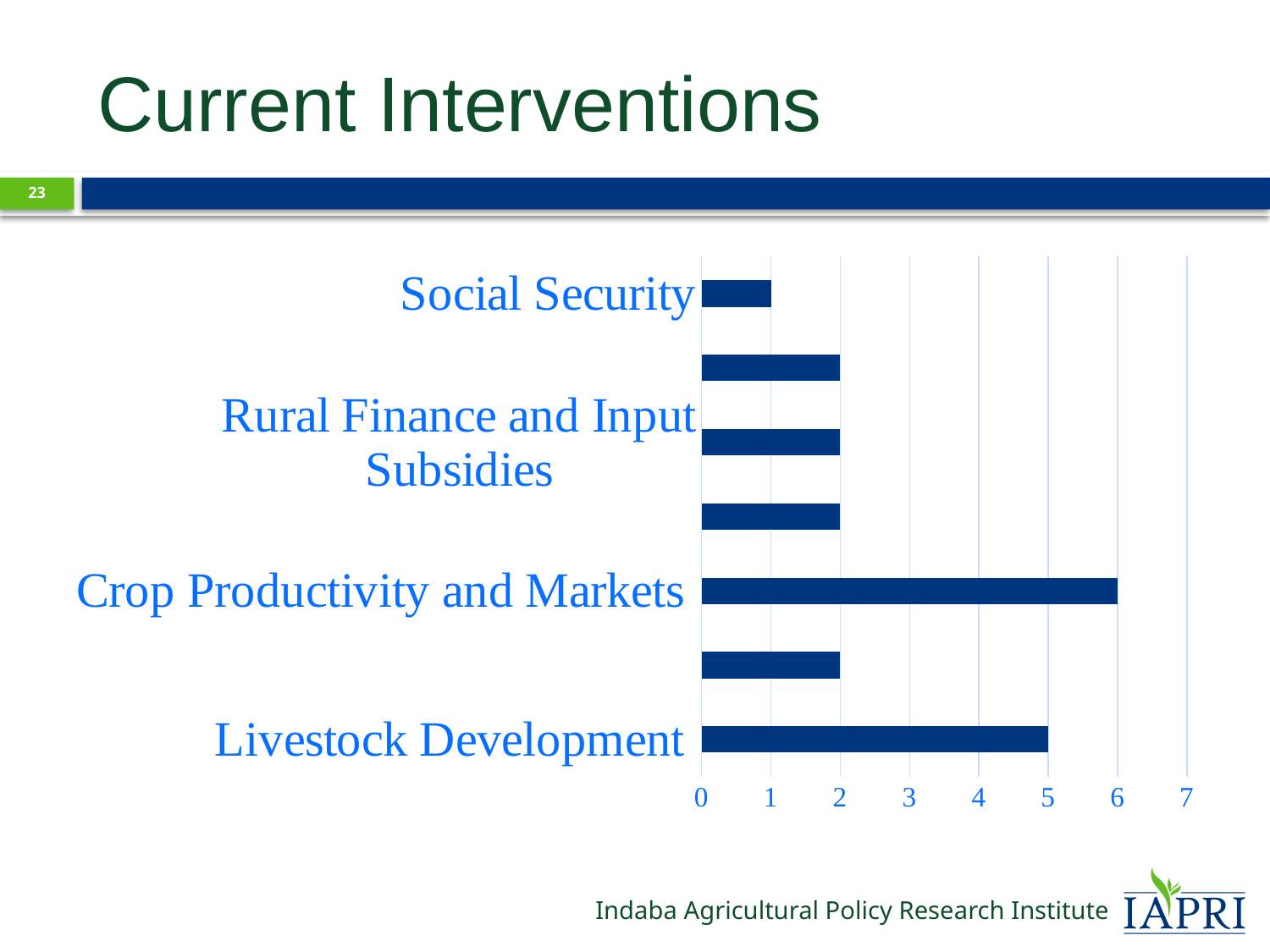
What kind of chart is shown on the slide? bar chart What is the value for Social Security? 1 Which is larger, the value for Livestock Development or the value for Rural Finance and Input Subsidies? Livestock Development Which category has the highest value? Crop Productivity and Markets What is the value for Crop Productivity and Markets? 6 What is the difference between the values for Livestock Development and Social Security? 4 Is the value for Crop Productivity and Markets greater or less than 5? greater What is the value for Livestock Development? 5 What is the difference between the values for Crop Productivity and Markets and Livestock Development? 1 Which category has the lowest value? Social Security What is the value for Rural Finance and Input Subsidies? 2 How many bars are plotted in the chart? 7